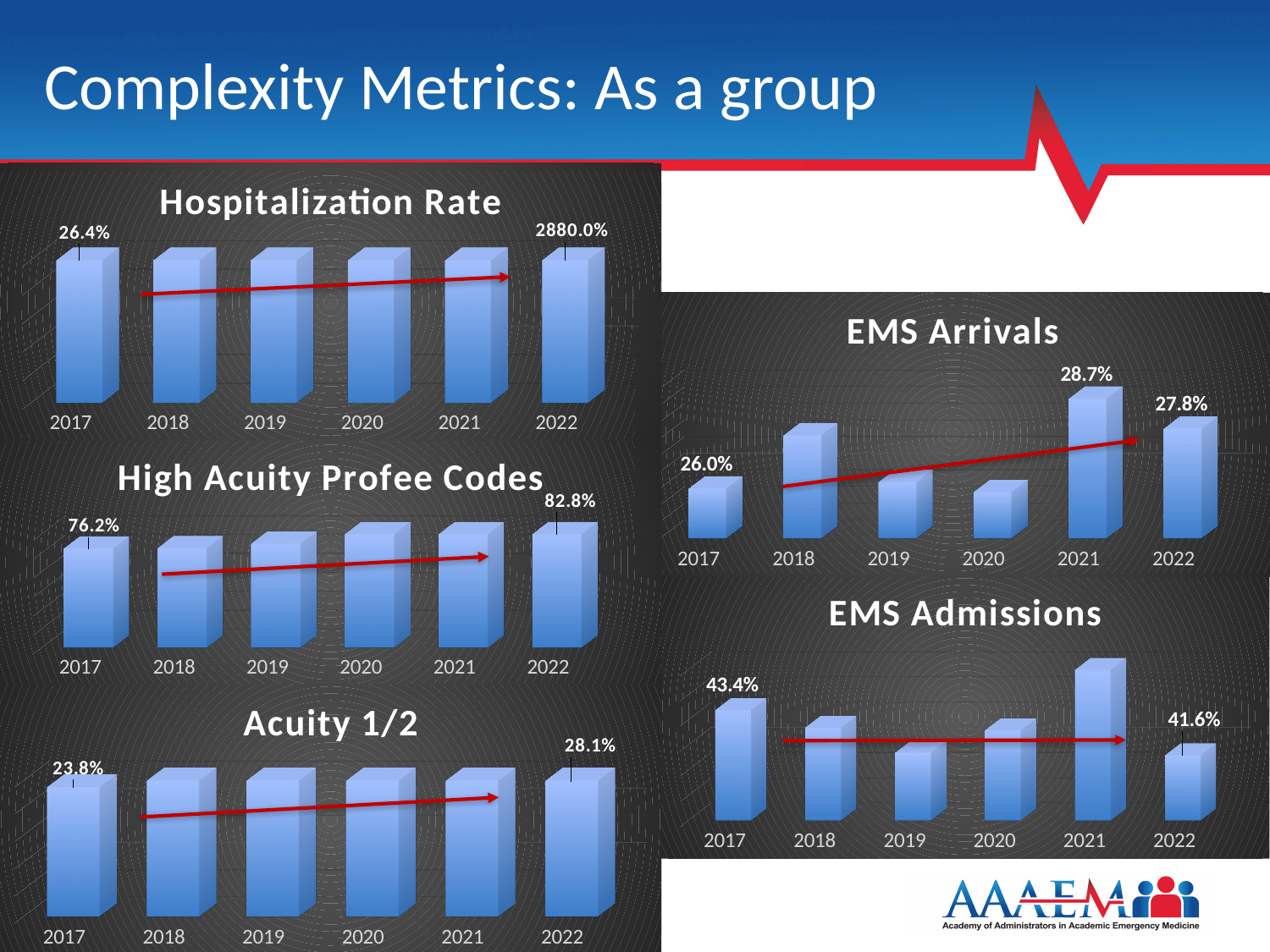
In the Hospitalization Rate chart, what value is labelled for 2022? 2880.0% How many years are shown on the x axis of the EMS Admissions chart? 6 In the EMS Arrivals chart, what is the difference between the 2021 and 2022 values? 0.9 percentage points In the Acuity 1/2 chart, what is the value for 2017? 23.8% In the EMS Arrivals chart, what is the value for 2021? 28.7% In the Acuity 1/2 chart, how much higher is the 2022 value than the 2017 value? 4.3 percentage points In the EMS Admissions chart, which is larger, the 2017 value or the 2022 value? 2017 In the Hospitalization Rate chart, what is the value for 2017? 26.4% In the High Acuity Profee Codes chart, what is the value for 2022? 82.8% In the High Acuity Profee Codes chart, what is the difference between the 2022 and 2017 values? 6.6 percentage points In the EMS Arrivals chart, which year has the highest bar? 2021